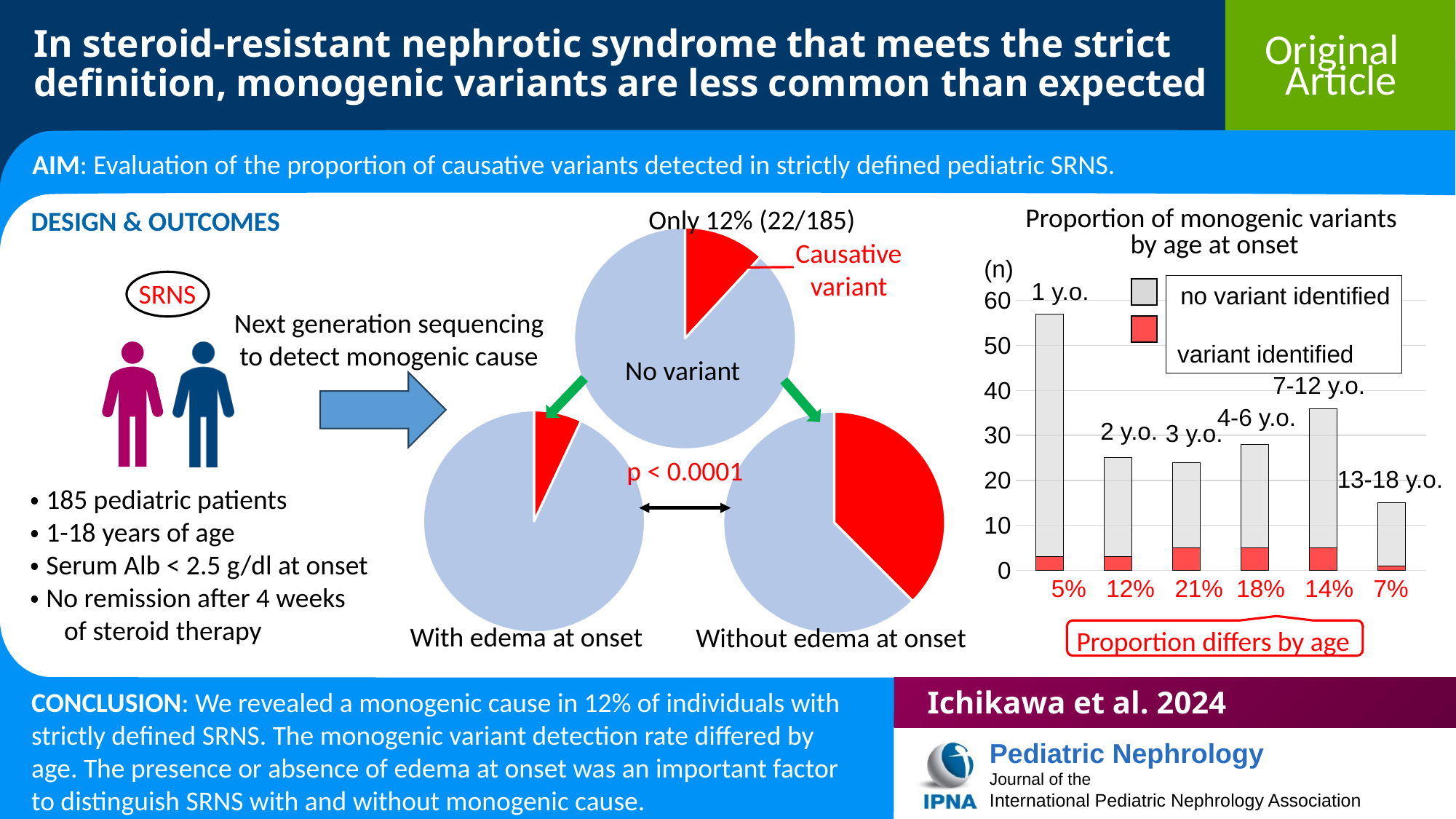
In the chart 'Proportion of monogenic variants by age at onset', what percentage is printed under the 3 y.o. bar? 21% In the chart 'Proportion of monogenic variants by age at onset', which bar is taller in total, 1 y.o. or 7-12 y.o.? 1 y.o. In the chart 'Proportion of monogenic variants by age at onset', what percentage is printed under the 13-18 y.o. bar? 7% In the chart 'Proportion of monogenic variants by age at onset', which age group has the highest printed percentage of variants identified? 3 y.o. In the chart 'Proportion of monogenic variants by age at onset', which age group has the lowest printed percentage of variants identified? 1 y.o. What kind of chart is 'Proportion of monogenic variants by age at onset'? Stacked bar chart In the large pie chart in the middle of the slide, what share of patients had a causative variant? 12% In the chart 'Proportion of monogenic variants by age at onset', how many series does the legend list? 2 In the chart 'Proportion of monogenic variants by age at onset', is the total height of the 13-18 y.o. bar greater or less than 20? less In the chart 'Proportion of monogenic variants by age at onset', what is the difference between the printed percentages for 3 y.o. and 1 y.o.? 16% In the chart 'Proportion of monogenic variants by age at onset', how many age groups are shown? 6 In the chart 'Proportion of monogenic variants by age at onset', is the total height of the 1 y.o. bar greater or less than 50? greater